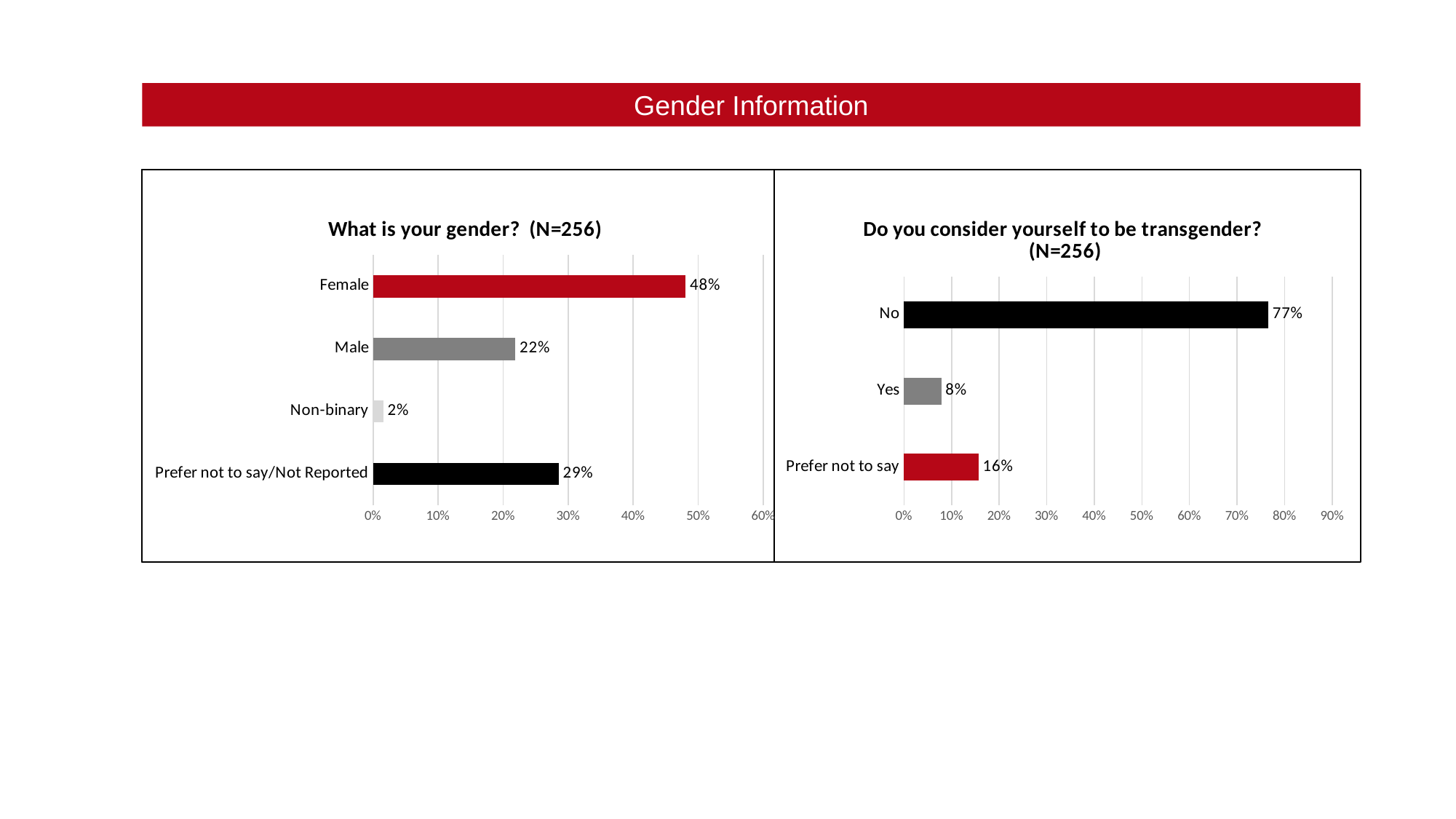
In the 'What is your gender?' chart, what is the value for Prefer not to say/Not Reported? 29% In the 'Do you consider yourself to be transgender?' chart, which category has the highest value? No How many categories are shown in the 'What is your gender?' chart? 4 What is the sample size (N) shown in the title of the 'What is your gender?' chart? 256 In the 'What is your gender?' chart, what is the difference between the Female and Male values? 26% In the 'Do you consider yourself to be transgender?' chart, what is the difference between the No and Prefer not to say values? 61% What kind of chart is the 'Do you consider yourself to be transgender?' chart? Bar chart In the 'What is your gender?' chart, which is larger: Male or Prefer not to say/Not Reported? Prefer not to say/Not Reported In the 'What is your gender?' chart, what is the value for Female? 48% In the 'Do you consider yourself to be transgender?' chart, what is the value for Prefer not to say? 16% In the 'What is your gender?' chart, which category has the lowest value? Non-binary In the 'Do you consider yourself to be transgender?' chart, what is the value for Yes? 8%